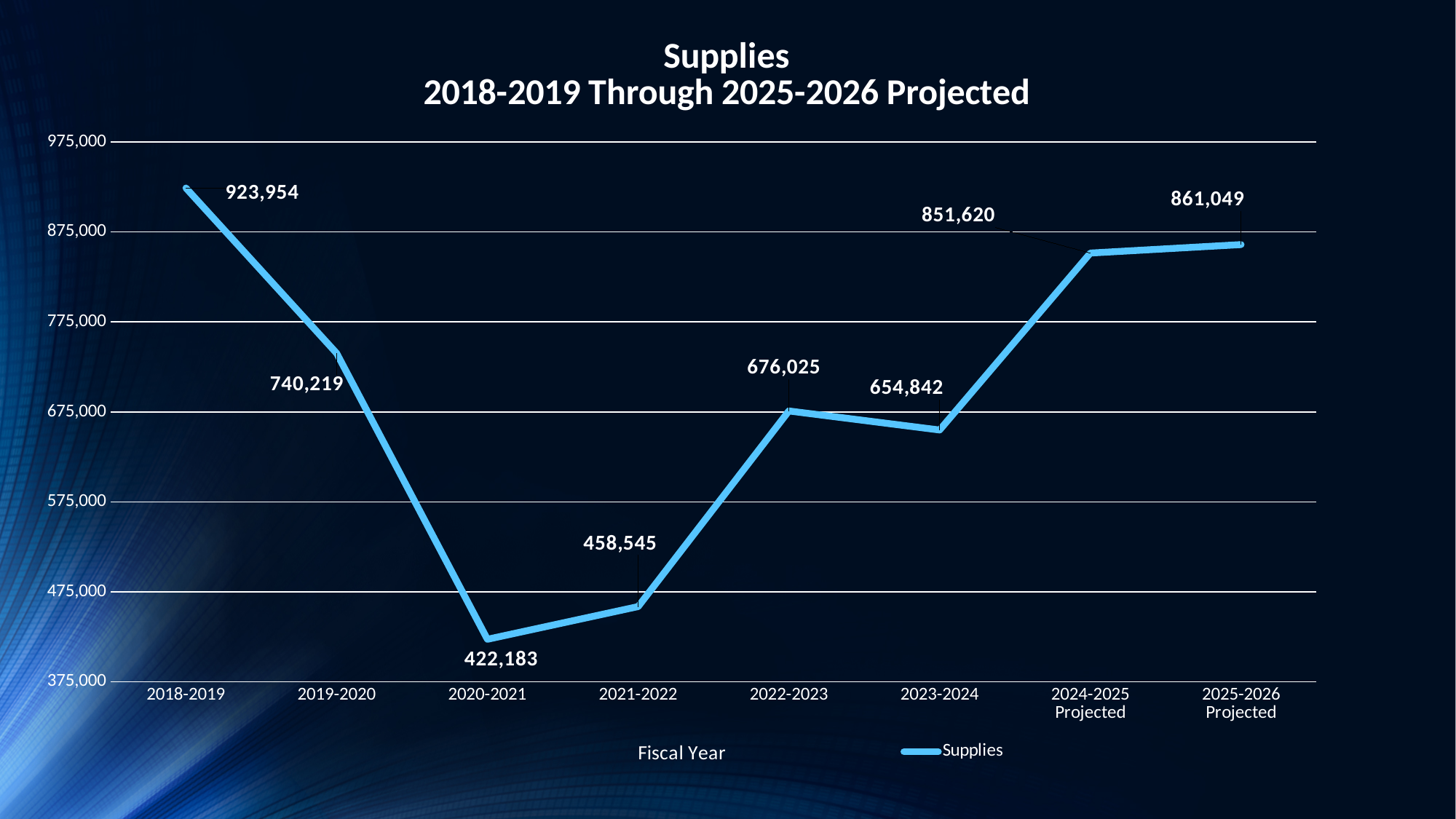
What is the Supplies value for 2021-2022? 458,545 What is the Supplies value for 2018-2019? 923,954 Is the Supplies value for 2020-2021 greater or less than 475,000? less What kind of chart is shown on the slide? line chart What is the projected Supplies value for 2025-2026? 861,049 How many fiscal years are plotted on the chart? 8 Which is larger, the Supplies value for 2024-2025 Projected or 2025-2026 Projected? 2025-2026 Projected What is the difference between the Supplies values for 2022-2023 and 2023-2024? 21,183 Which fiscal year has the highest Supplies value? 2018-2019 Which fiscal year has the lowest Supplies value? 2020-2021 What is the label of the x axis? Fiscal Year What is the difference between the Supplies values for 2018-2019 and 2019-2020? 183,735